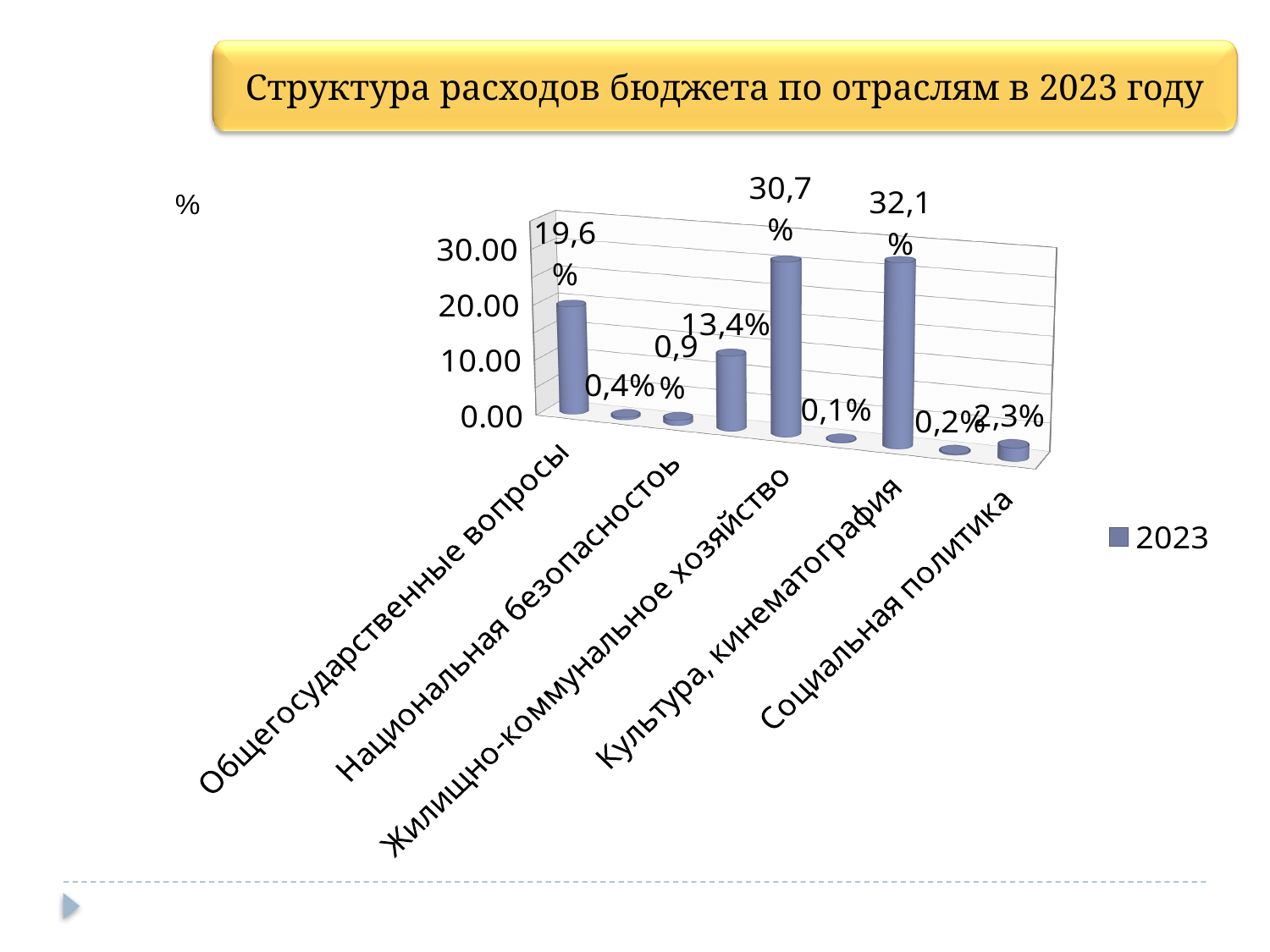
Is the value for Общегосударственные вопросы greater or less than 10.00? greater How many series does the legend list? 1 What is the lowest value labelled on the chart? 0,1% What is the value for Жилищно-коммунальное хозяйство? 30,7% What type of chart is shown on the slide? bar chart What is the highest value labelled on the chart? 32,1% What is the legend entry for the series shown? 2023 What is the value for Общегосударственные вопросы? 19,6% Which is larger, the value for Жилищно-коммунальное хозяйство or the value for Общегосударственные вопросы? Жилищно-коммунальное хозяйство What is the value for Национальная безопасность? 0,9% How many bars are plotted in the chart? 9 What is the value for Социальная политика? 2,3%